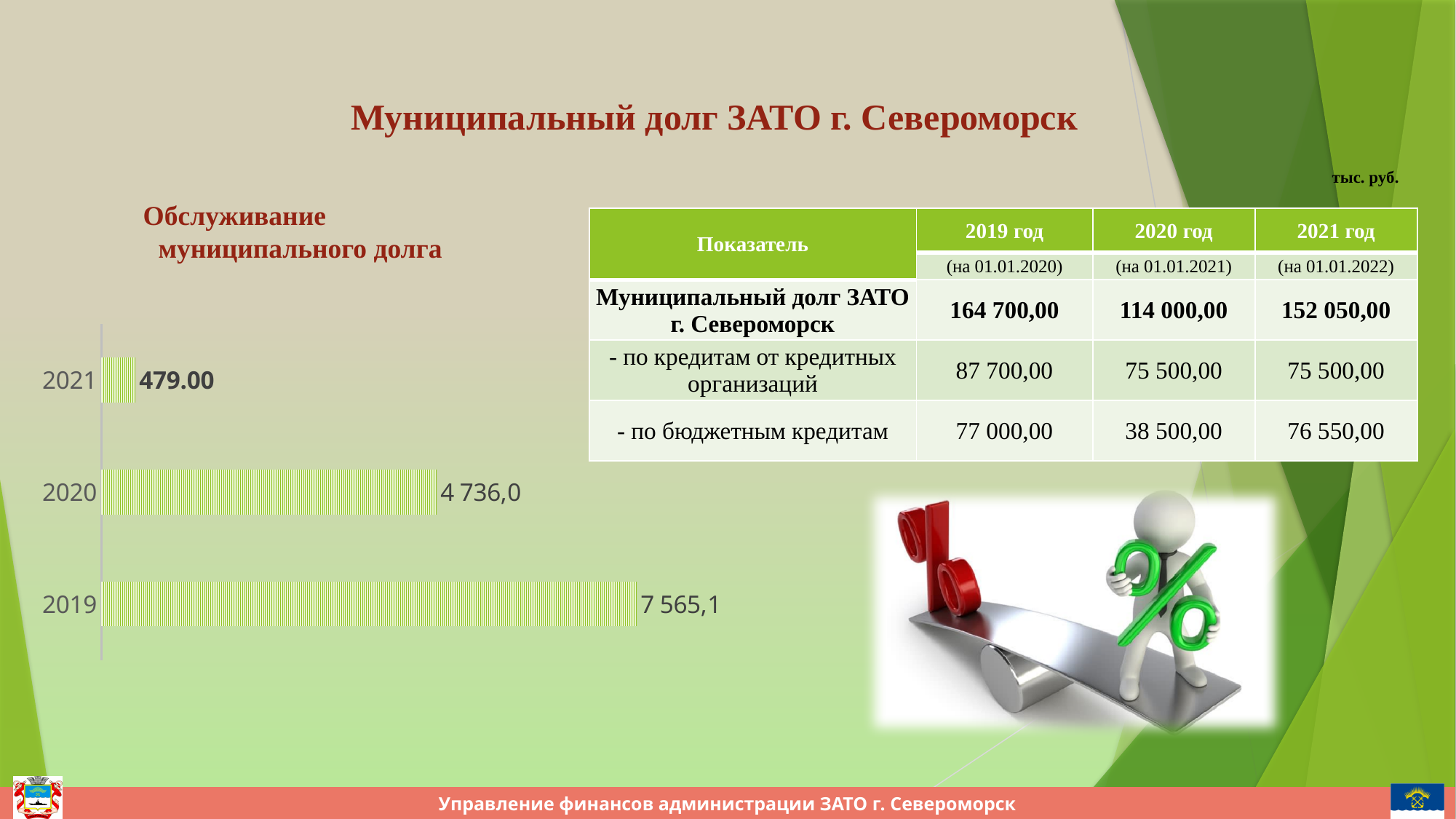
What is the value for 2020 in the chart "Обслуживание муниципального долга"? 4 736,0 In the chart "Обслуживание муниципального долга", do the values rise or fall from 2019 to 2021? fall In the chart "Обслуживание муниципального долга", what is the difference between the values for 2020 and 2021? 4 257,0 What is the title of the bar chart on the slide? Обслуживание муниципального долга Which year has the highest value in the chart "Обслуживание муниципального долга"? 2019 What kind of chart is "Обслуживание муниципального долга"? bar chart How many years are shown in the chart "Обслуживание муниципального долга"? 3 Which year has the lowest value in the chart "Обслуживание муниципального долга"? 2021 In the chart "Обслуживание муниципального долга", what is the difference between the values for 2019 and 2020? 2 829,1 In the chart "Обслуживание муниципального долга", which is larger: the value for 2020 or the value for 2021? 2020 What is the value for 2019 in the chart "Обслуживание муниципального долга"? 7 565,1 What is the value for 2021 in the chart "Обслуживание муниципального долга"? 479.00